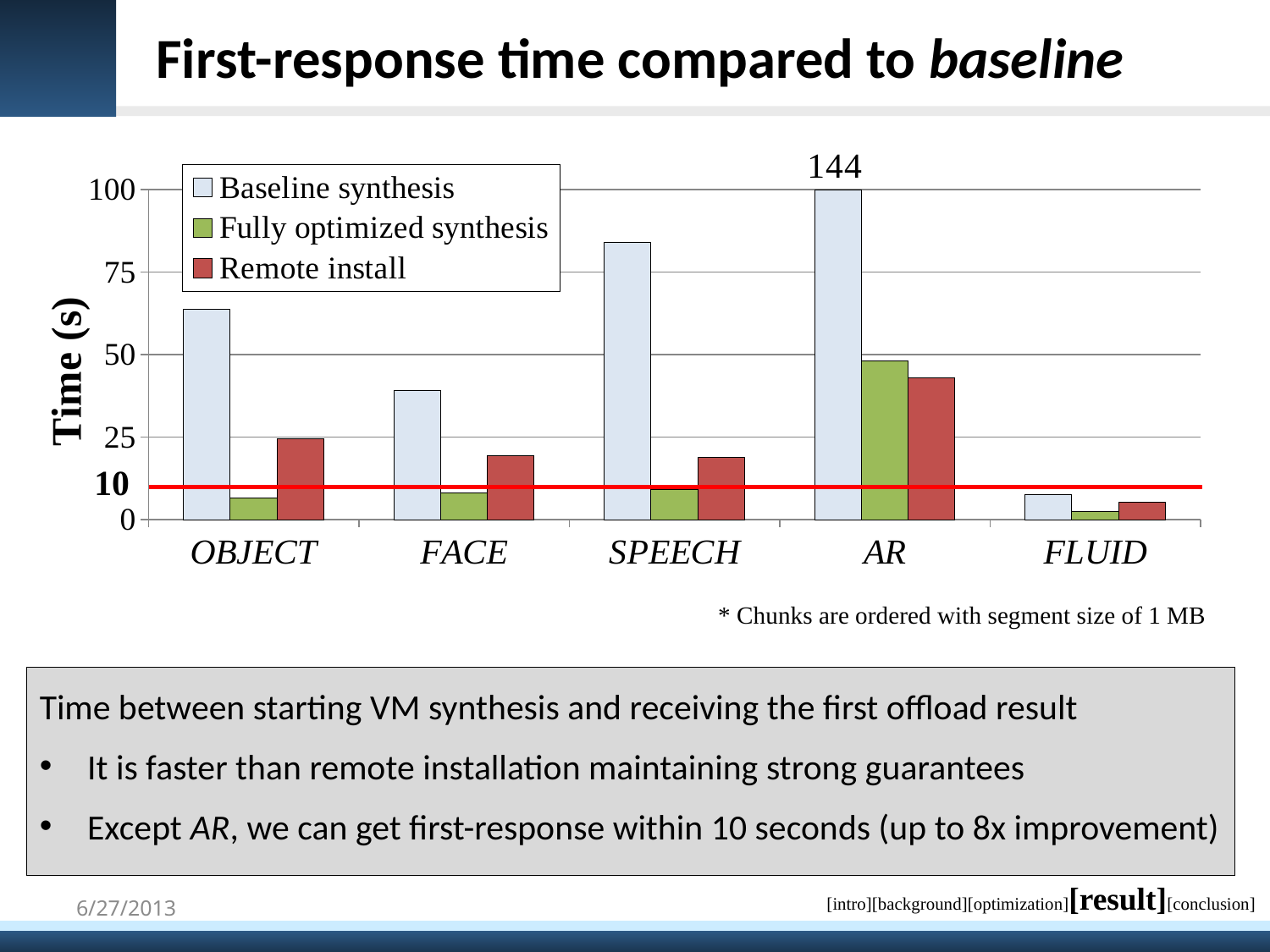
How many series does the chart's legend list? 3 How many categories are shown on the x axis of the chart? 5 What kind of chart is shown on the slide? bar chart Is the Baseline synthesis value for OBJECT greater or less than 50? greater Which category has the lowest Baseline synthesis value? FLUID What value does the red horizontal line on the chart mark? 10 For SPEECH, which is larger: Baseline synthesis or Remote install? Baseline synthesis Which category has the highest Fully optimized synthesis value? AR What is the Baseline synthesis value for AR? 144 Is the Remote install value for AR greater or less than 25? greater Which category has the highest Baseline synthesis value? AR Is the Fully optimized synthesis value for FACE greater or less than 10? less